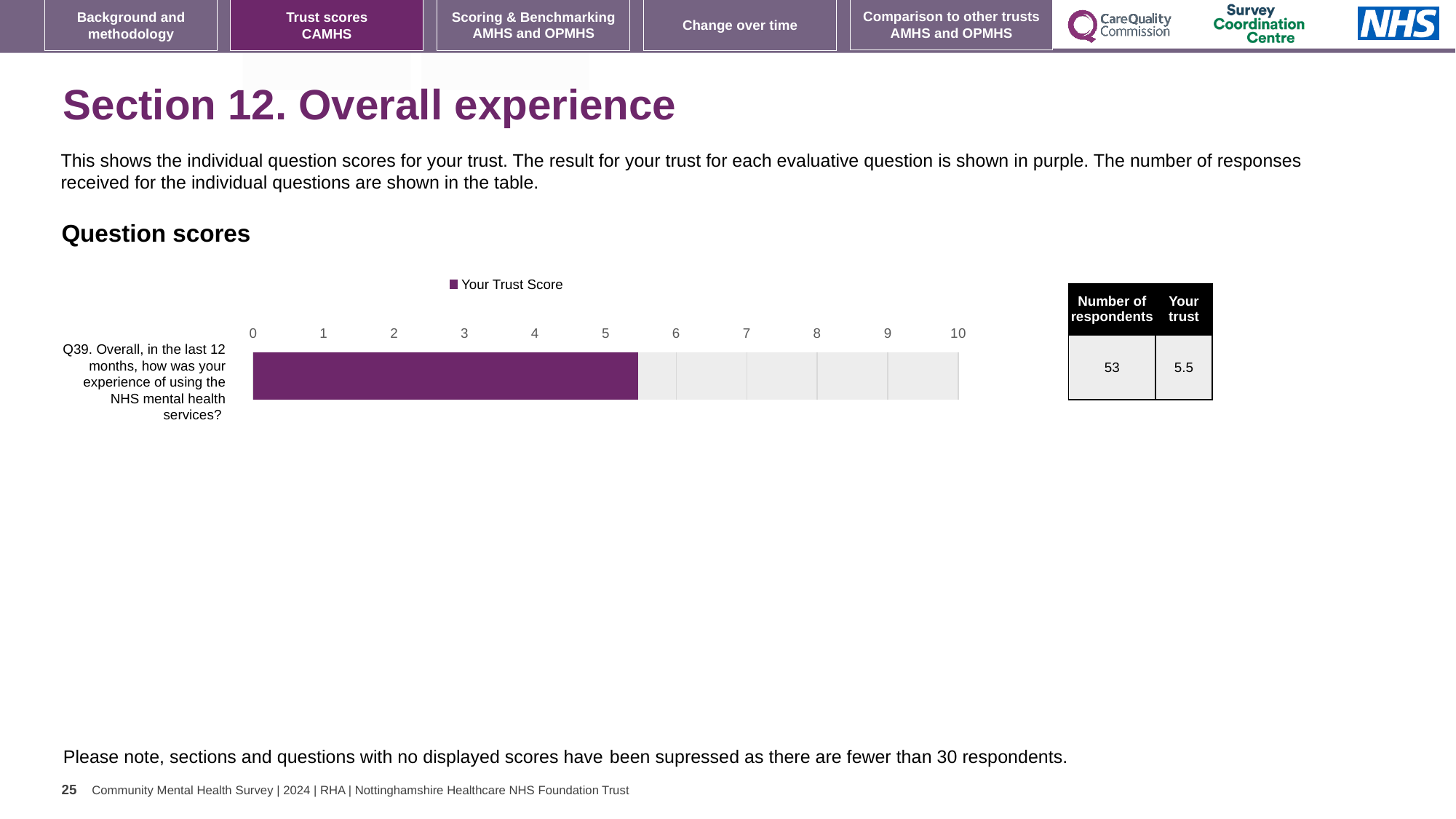
What is the name of the series shown in the legend of the Question scores chart? Your Trust Score What kind of chart is shown under 'Question scores'? bar chart What is the trust score for Q39 in the Question scores chart? 5.5 How many series does the legend of the Question scores chart list? 1 How many questions (categories) are plotted in the Question scores chart? 1 Is the value for Q39 in the Question scores chart greater or less than 5? greater Is the value for Q39 in the Question scores chart greater or less than 6? less What is the maximum value shown on the x axis of the Question scores chart? 10 Is the value for Q39 in the Question scores chart greater or less than 8? less